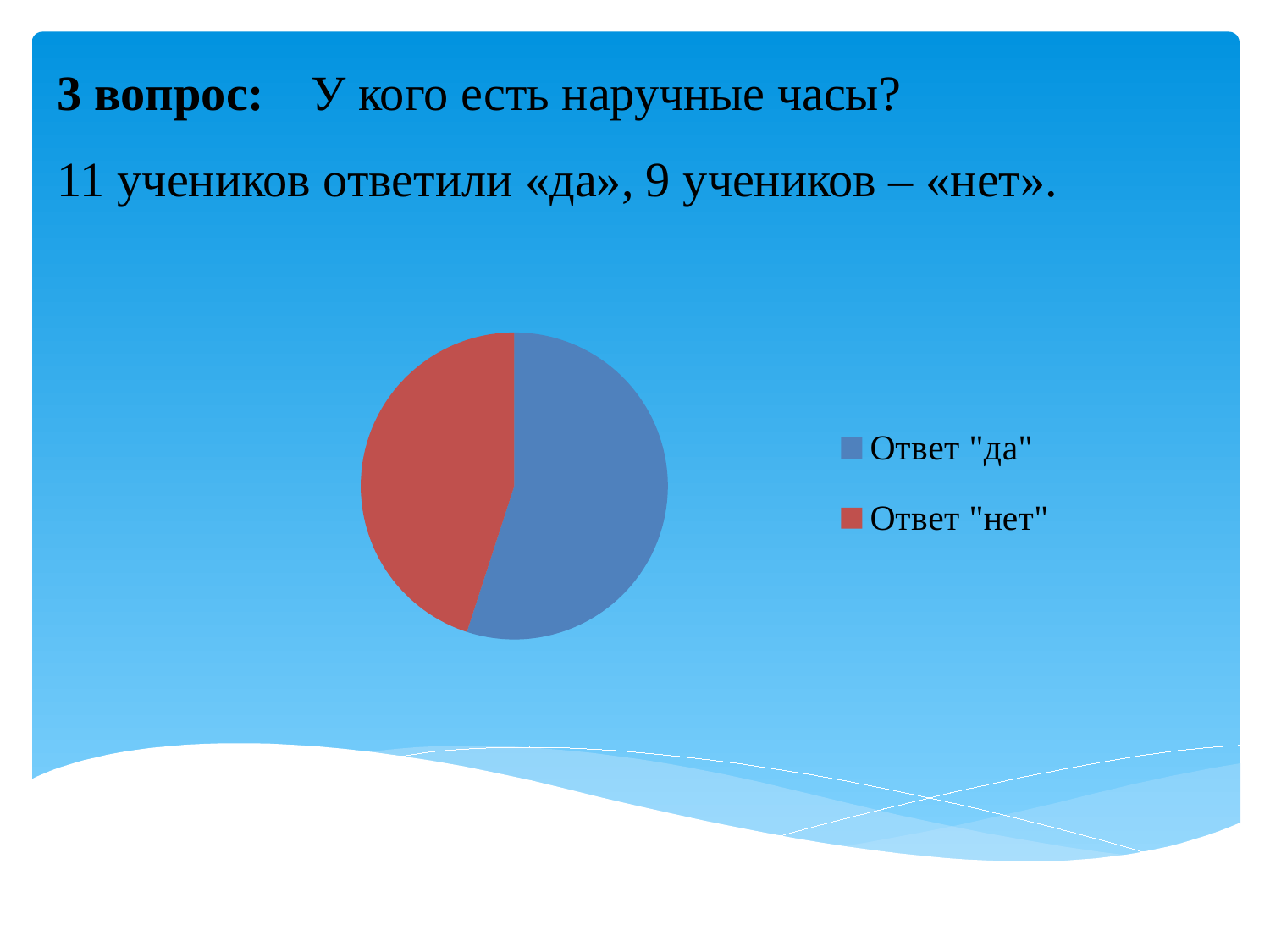
What kind of chart is shown on the slide? pie chart What colour is the Ответ "да" slice in the pie chart? blue How many entries does the legend of the pie chart list? 2 How many students answered "да" according to the slide? 11 Which slice of the pie chart is the smallest? Ответ "нет" What colour is the Ответ "нет" slice in the pie chart? red How many slices does the pie chart have? 2 Which is larger in the pie chart: Ответ "да" or Ответ "нет"? Ответ "да" Which slice of the pie chart is the largest? Ответ "да" How many students answered "нет" according to the slide? 9 How many more students answered "да" than "нет"? 2